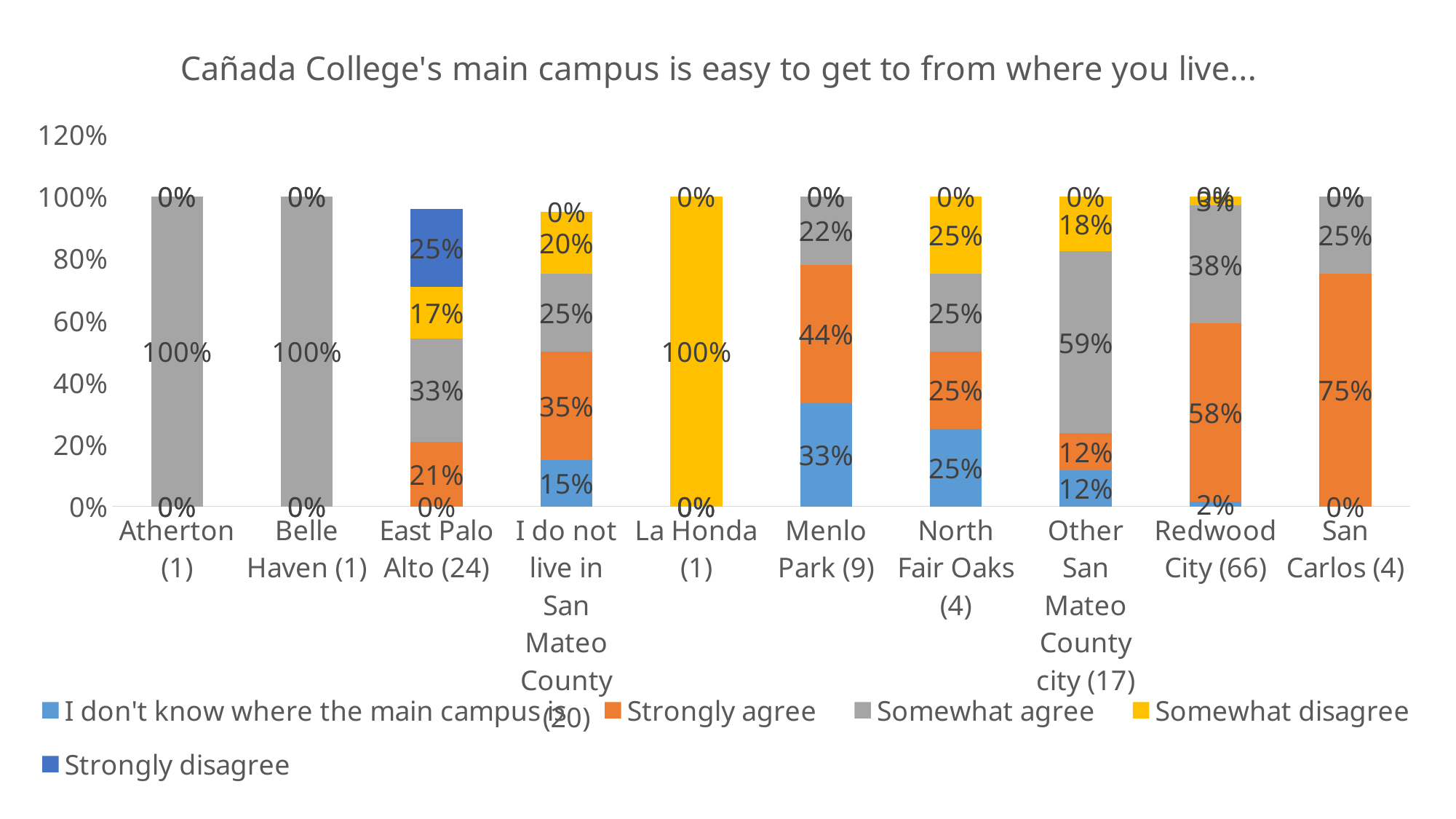
What is the Strongly disagree value for East Palo Alto (24)? 25% What kind of chart is shown on the slide? Stacked bar chart How many series does the legend list? 5 What is the 'I don't know where the main campus is' value for Menlo Park (9)? 33% What is the Somewhat agree value for Other San Mateo County city (17)? 59% What is the difference between the Strongly agree values for Redwood City (66) and Menlo Park (9)? 14% Which is larger: the Somewhat agree value for Redwood City (66) or for East Palo Alto (24)? Redwood City (66) How many categories are shown on the x axis? 10 What is the Somewhat disagree value for La Honda (1)? 100% Which category has the highest Strongly agree value? San Carlos (4) Which category has the highest Strongly disagree value? East Palo Alto (24) What is the Strongly agree value for San Carlos (4)? 75%